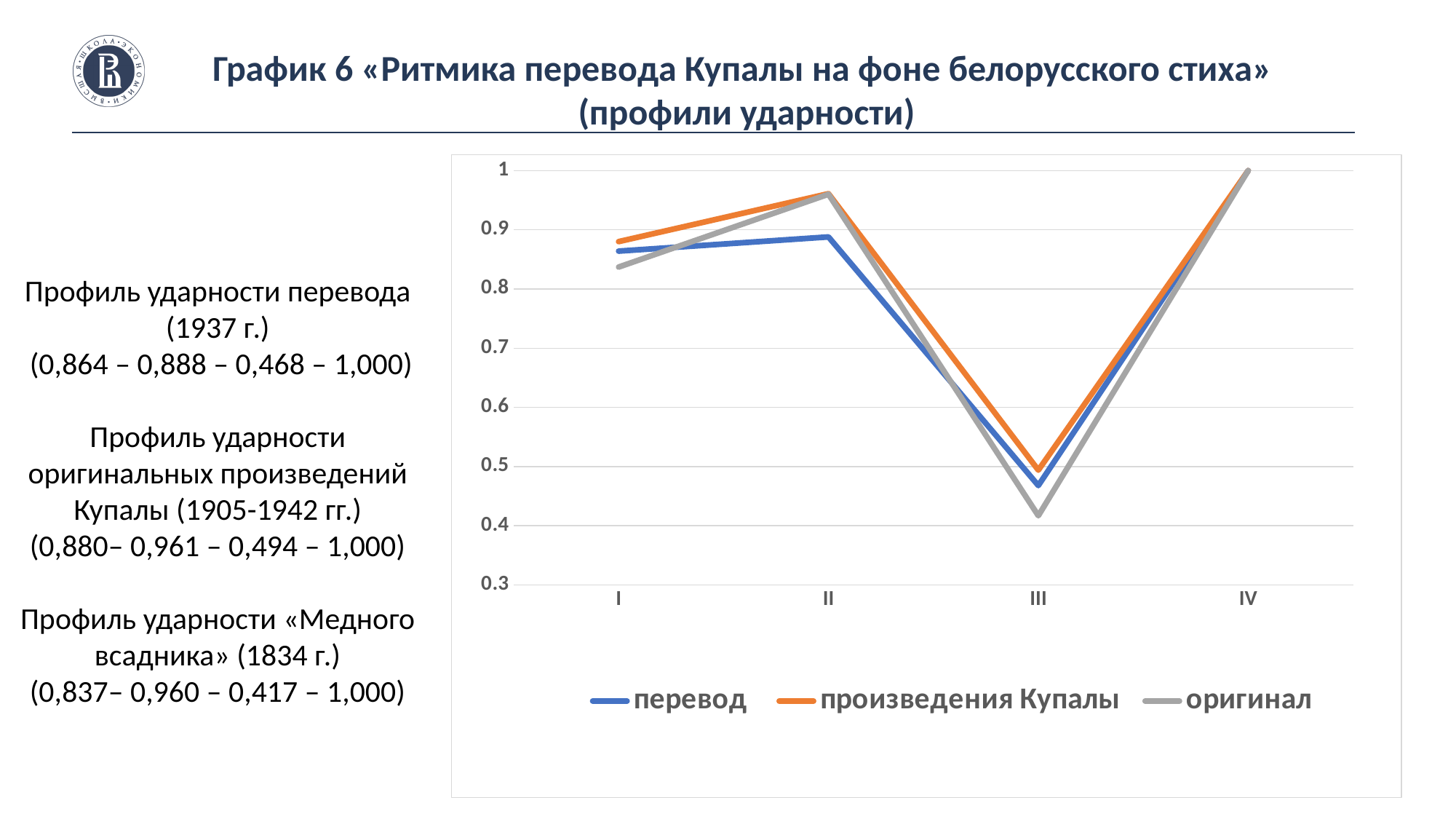
Do the values of all three series rise or fall from position II to position III? fall Which series has the lowest value at position III? оригинал What is the value of the оригинал series at position I? 0,837 At which position does the оригинал series reach its lowest value? III At position II, which is larger: перевод or произведения Купалы? произведения Купалы What type of chart is shown on the slide? line chart What is the difference between the произведения Купалы and оригинал values at position III? 0,077 How many positions are marked on the x axis of the chart? 4 How many series does the legend of the chart list? 3 Is the value of the перевод series at position III greater or less than 0.5? less What is the value of the перевод series at position III? 0,468 What is the value of the произведения Купалы series at position II? 0,961